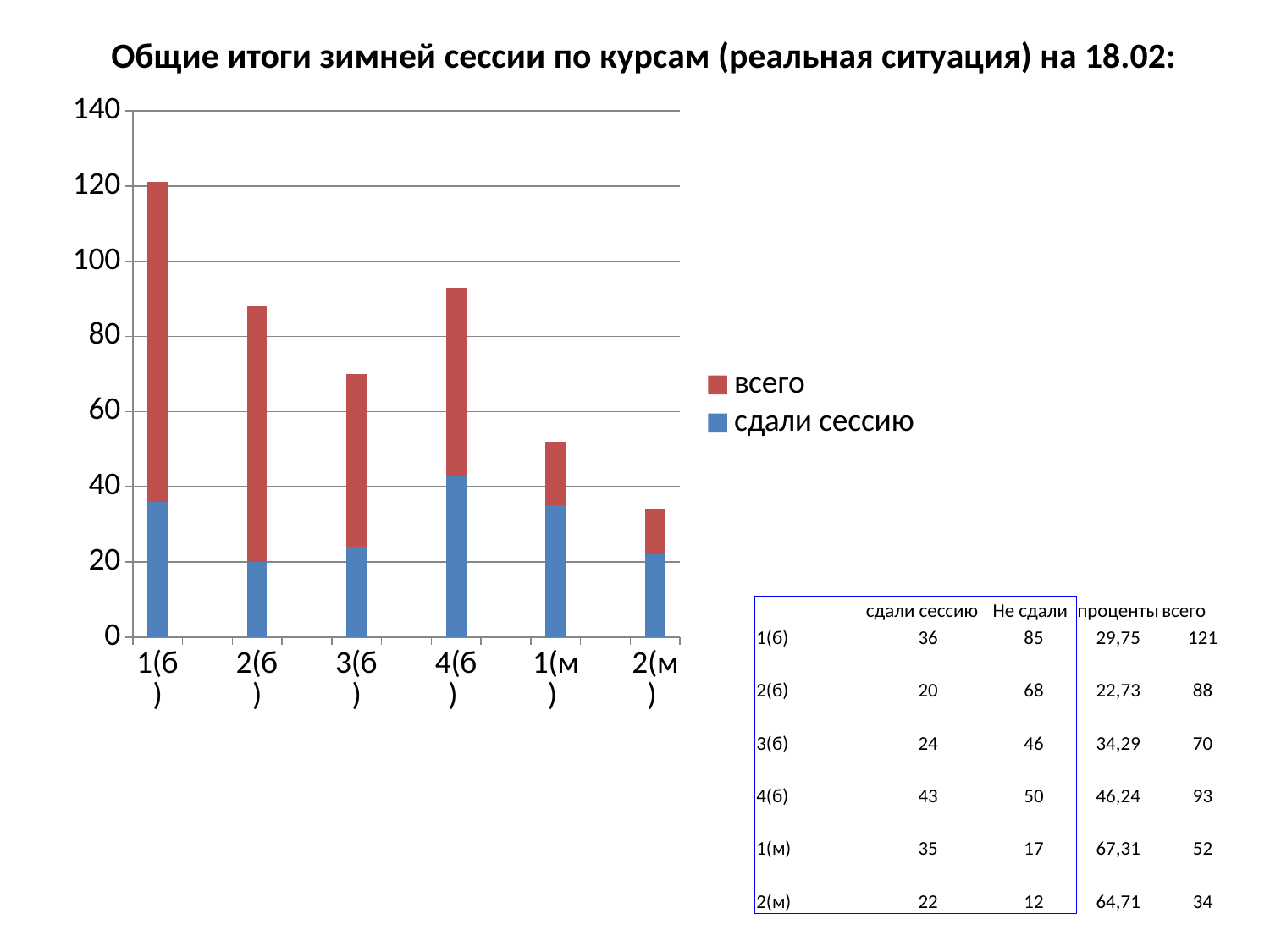
According to the table on the slide, what is the 'всего' value for 1(м)? 52 Which course has the tallest bar in the chart? 1(б) According to the table on the slide, what is the 'сдали сессию' value for 4(б)? 43 Which bar is taller in the chart, 3(б) or 4(б)? 4(б) Is the top of the bar for 2(м) greater or less than 40? less What are the two entries in the chart legend? всего, сдали сессию How many series does the chart legend list? 2 Is the top of the bar for 1(б) greater or less than 100? greater Which course has the shortest bar in the chart? 2(м) What kind of chart is shown on the slide? bar chart Using the 'всего' values in the table, what is the difference between 1(б) and 2(б)? 33 How many course categories are plotted along the x axis of the chart? 6